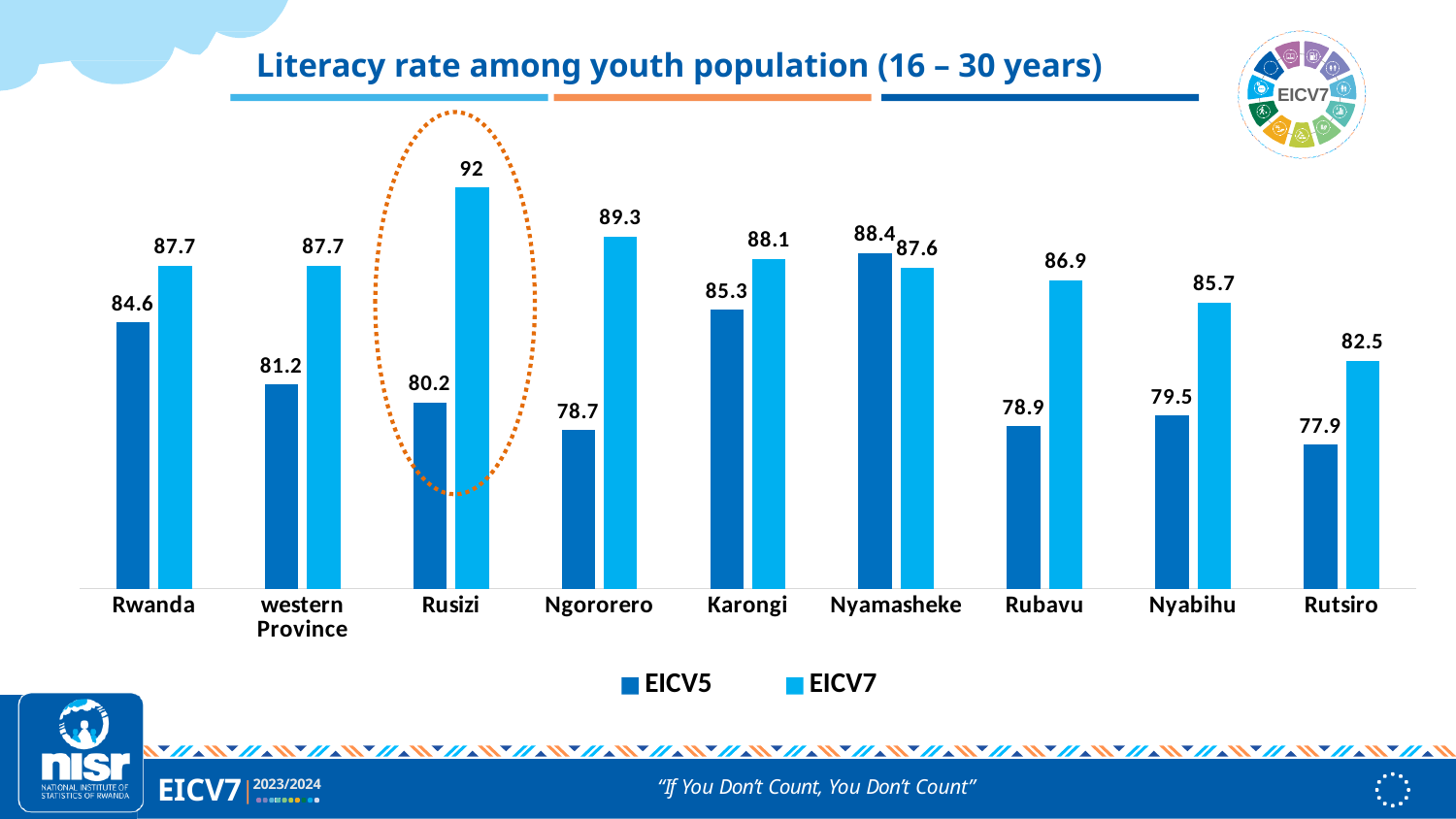
For Nyamasheke, which is larger: the EICV5 value or the EICV7 value? EICV5 Which category has the highest EICV5 value? Nyamasheke What is the EICV7 value for Rutsiro? 82.5 What is the EICV7 literacy rate for Rusizi? 92 How many series does the legend list? 2 What is the title of the chart? Literacy rate among youth population (16 – 30 years) What kind of chart is shown on the slide? Bar chart What is the EICV5 literacy rate for Ngororero? 78.7 Which category has the lowest EICV5 value? Rutsiro What is the difference between the EICV7 and EICV5 values for Rusizi? 11.8 Which category has the highest EICV7 value? Rusizi How many categories are shown on the x axis? 9